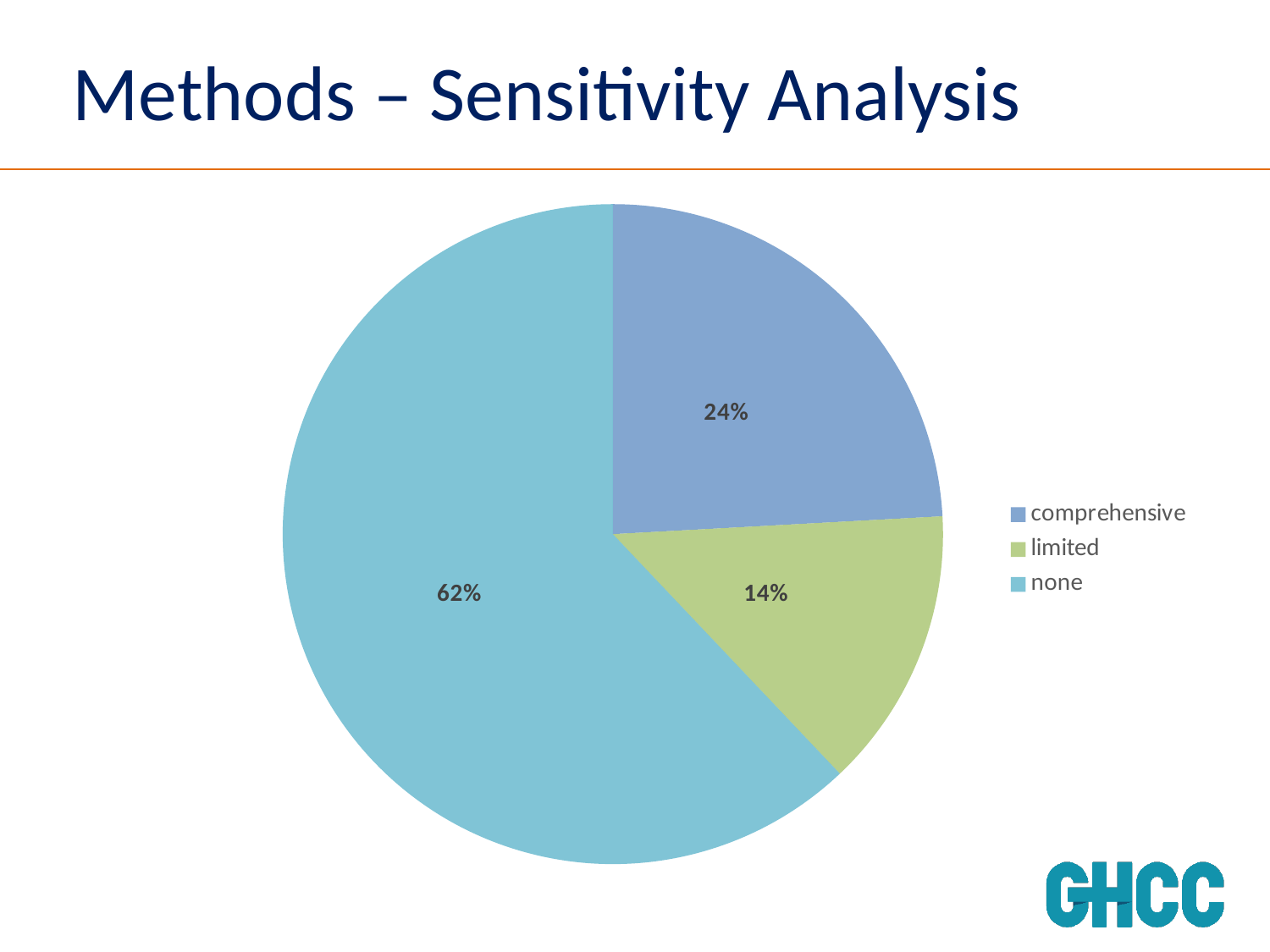
Which is larger, the 'comprehensive' slice or the 'limited' slice? comprehensive What is the difference in percentage points between the 'comprehensive' slice and the 'limited' slice? 10 Which category has the smallest slice of the pie? limited What is the title of the slide containing the pie chart? Methods – Sensitivity Analysis What share of the pie does the 'limited' slice represent? 14% What is the difference in percentage points between the 'none' slice and the 'comprehensive' slice? 38 What share of the pie does the 'none' slice represent? 62% How many slices does the pie chart have? 3 Which category has the largest slice of the pie? none What kind of chart is shown on the slide? pie chart How many entries does the legend list? 3 What share of the pie does the 'comprehensive' slice represent? 24%